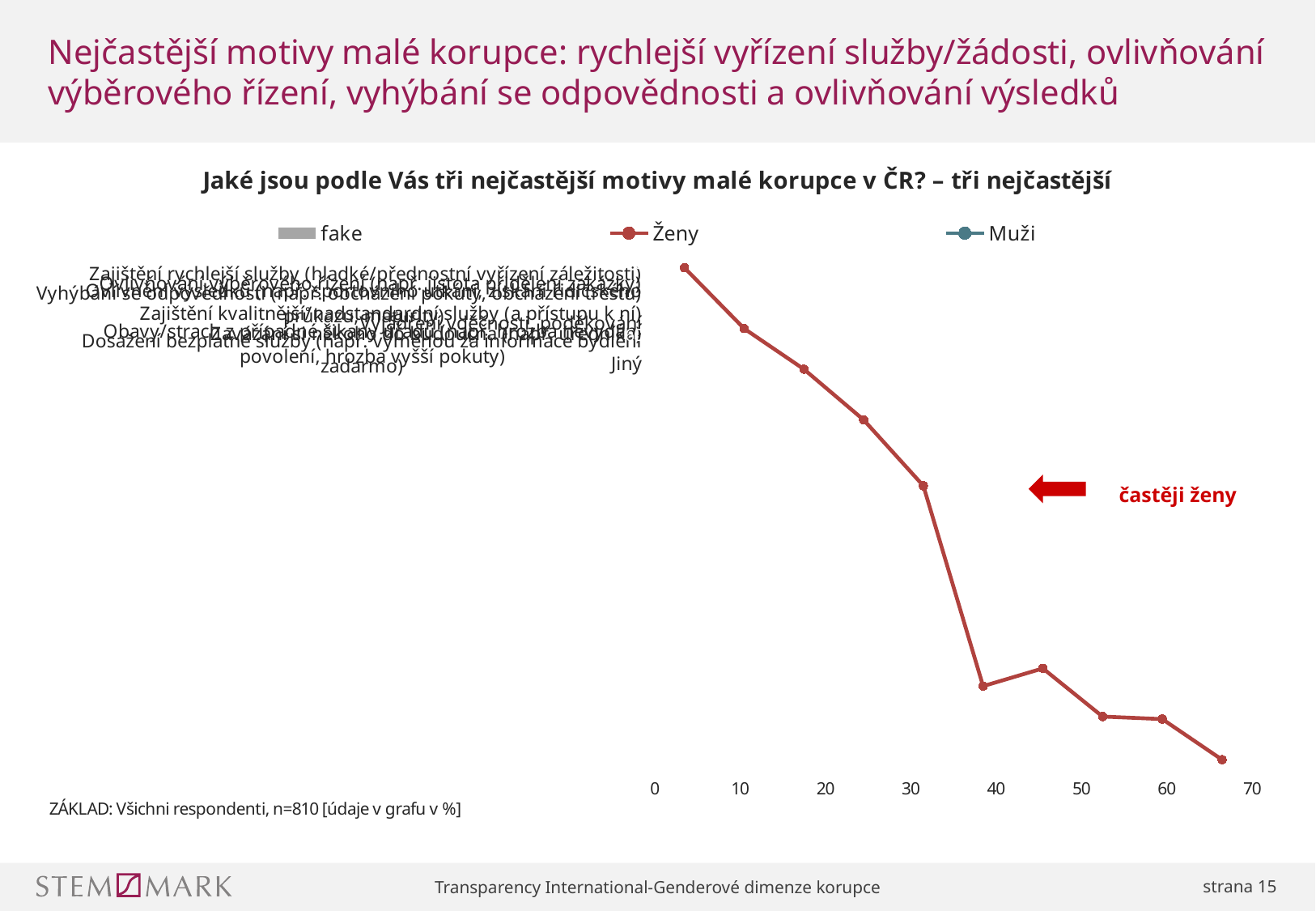
What kind of chart is shown on the slide? line chart How many series does the legend list? 3 Is the x-axis value of the rightmost point on the Ženy line greater or less than 60? greater Is the x-axis value of the leftmost point on the Ženy line greater or less than 10? less How many data points are plotted on the Ženy line? 10 What are the entries listed in the chart legend? fake, Ženy, Muži What is the lowest tick value shown on the x axis of the chart? 0 What does the red annotation text next to the arrow on the chart say? častěji ženy What is the highest tick value shown on the x axis of the chart? 70